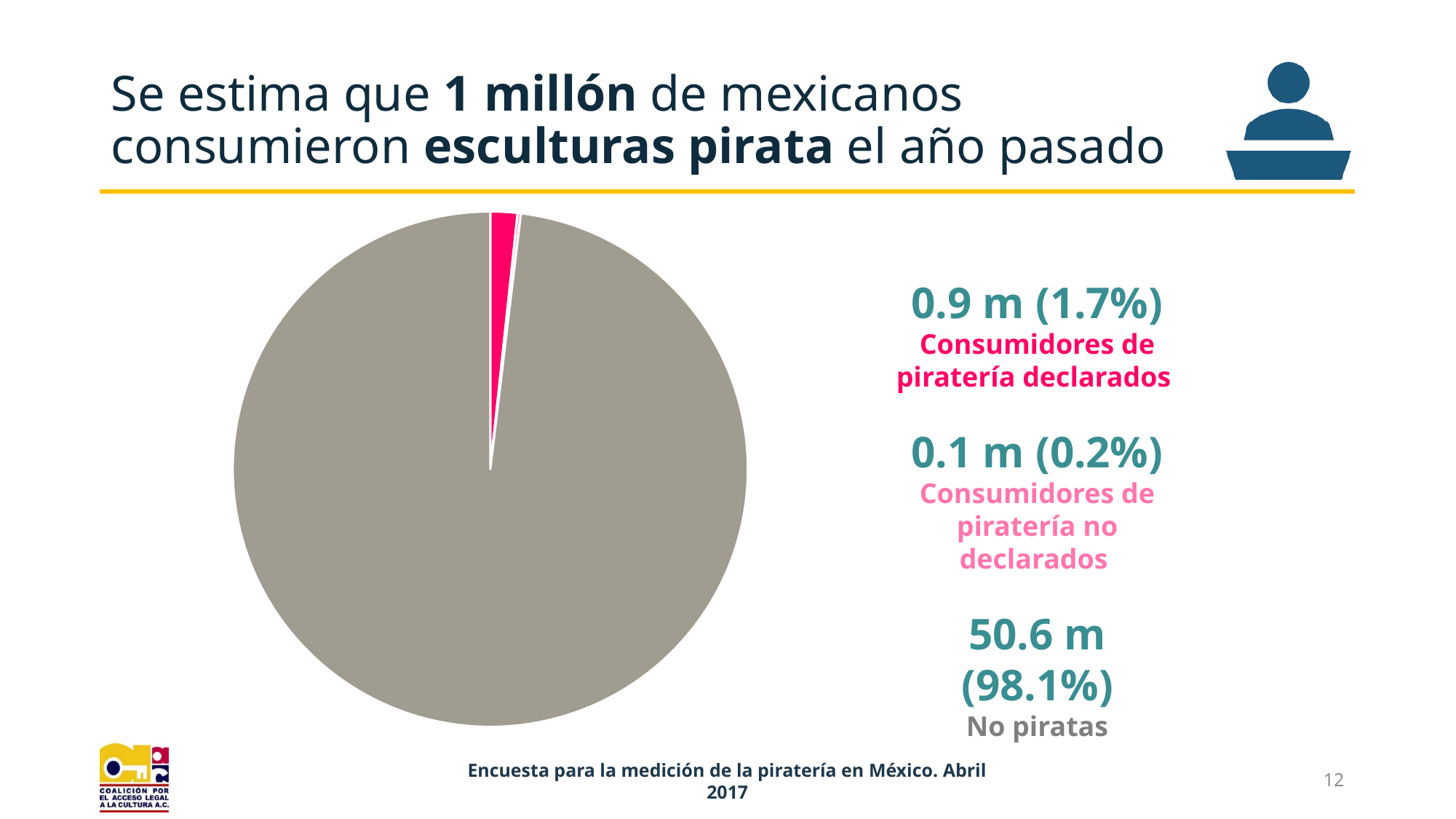
How many people (in millions) are 'Consumidores de piratería no declarados'? 0.1 m What kind of chart is shown on the slide? pie chart Which category has the smallest slice of the pie? Consumidores de piratería no declarados How many slices does the pie chart have? 3 How many people (in millions) are 'Consumidores de piratería declarados'? 0.9 m What share of the pie is labelled 'Consumidores de piratería declarados'? 1.7% What is the difference in percentage points between the 'No piratas' share and the 'Consumidores de piratería declarados' share? 96.4 Which is larger: the share for 'Consumidores de piratería declarados' or for 'Consumidores de piratería no declarados'? Consumidores de piratería declarados Which category has the largest slice of the pie? No piratas How many people (in millions) are 'No piratas'? 50.6 m What share of the pie is labelled 'Consumidores de piratería no declarados'? 0.2% What share of the pie is labelled 'No piratas'? 98.1%